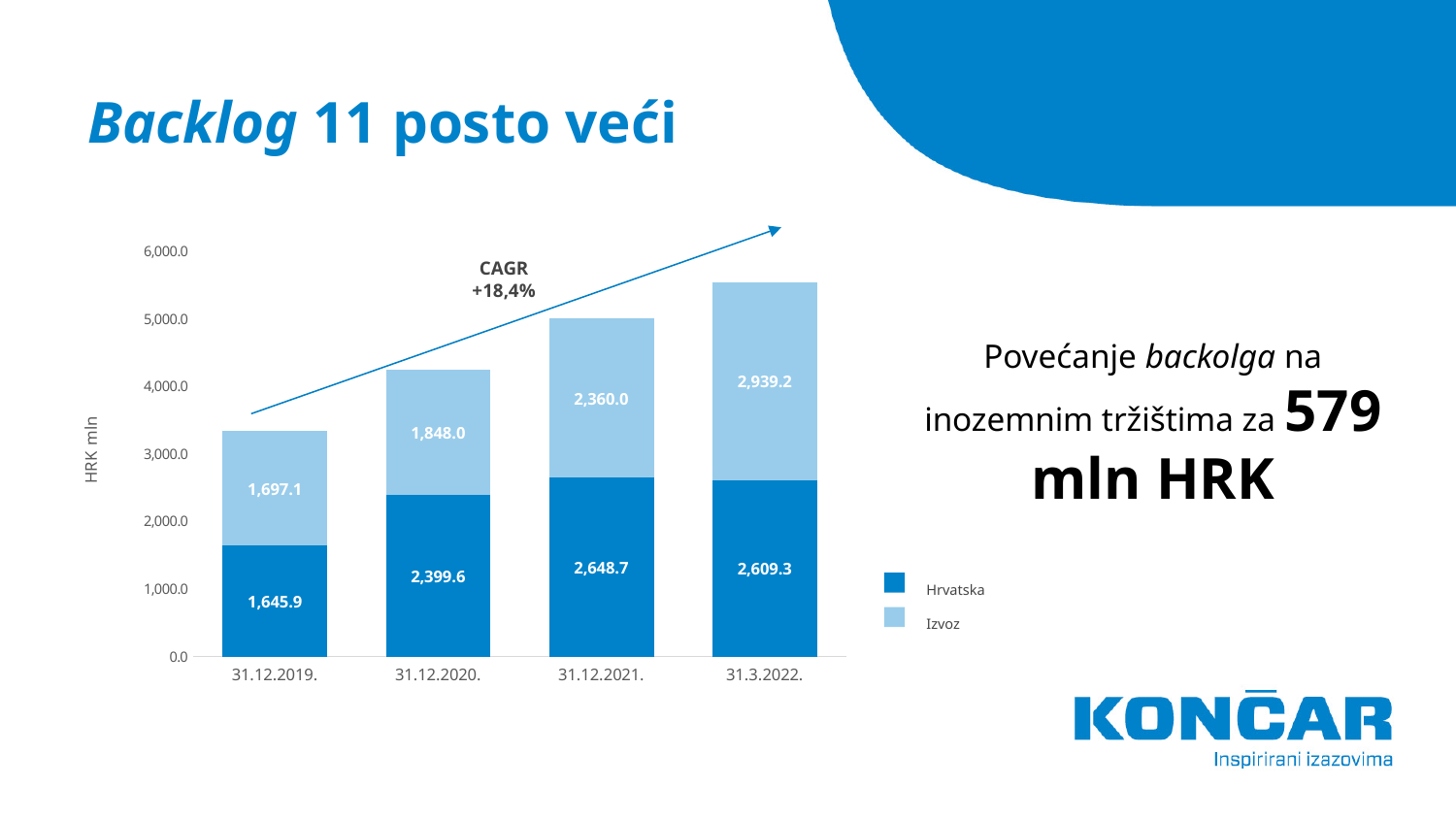
Which date has the lowest Izvoz value? 31.12.2019. What is the Hrvatska value for 31.12.2019.? 1,645.9 How many dates are shown on the x axis? 4 Which date has the highest Hrvatska value? 31.12.2021. For 31.12.2020., which is larger, Hrvatska or Izvoz? Hrvatska What is the difference between the Izvoz values for 31.3.2022. and 31.12.2021.? 579.2 What is the Izvoz value for 31.3.2022.? 2,939.2 What kind of chart is shown? Stacked bar chart What is the Izvoz value for 31.12.2020.? 1,848.0 What is the total of the stacked bar for 31.12.2021.? 5,008.7 What is the total of the stacked bar for 31.12.2019.? 3,343.0 How many series does the legend list? 2